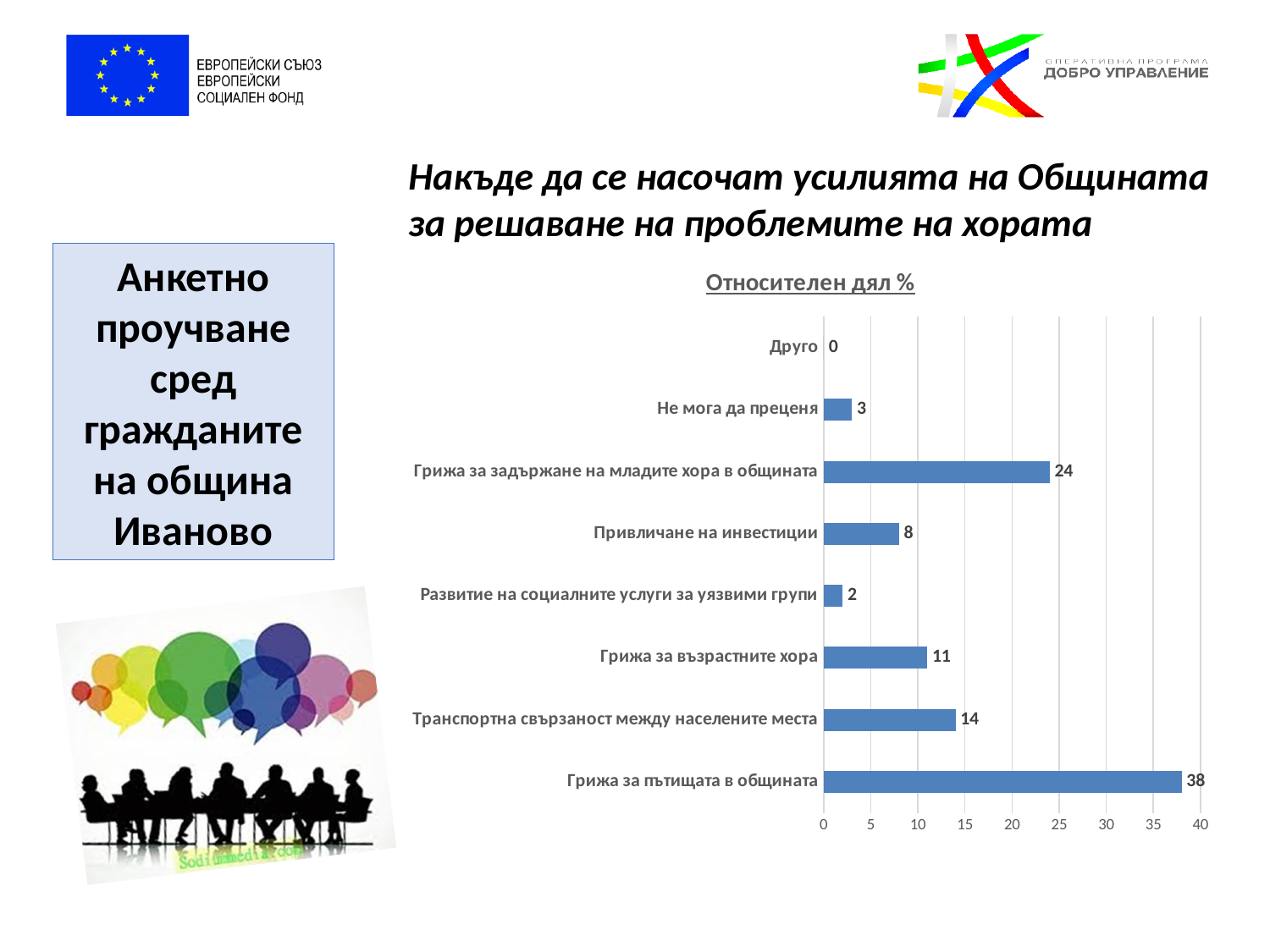
How many categories are shown in the chart? 8 What is the value for "Не мога да преценя"? 3 Which category has the highest value? Грижа за пътищата в общината What is the value for "Грижа за пътищата в общината"? 38 What is the value for "Развитие на социалните услуги за уязвими групи"? 2 What kind of chart is shown on the slide? bar chart Which category has the lowest value? Друго Is the value for "Грижа за задържане на младите хора в общината" greater or less than 20? greater Which is larger: "Транспортна свързаност между населените места" or "Грижа за възрастните хора"? Транспортна свързаност между населените места What is the difference between "Грижа за пътищата в общината" and "Грижа за задържане на младите хора в общината"? 14 What is the value for "Привличане на инвестиции"? 8 What is the title of the chart? Относителен дял %